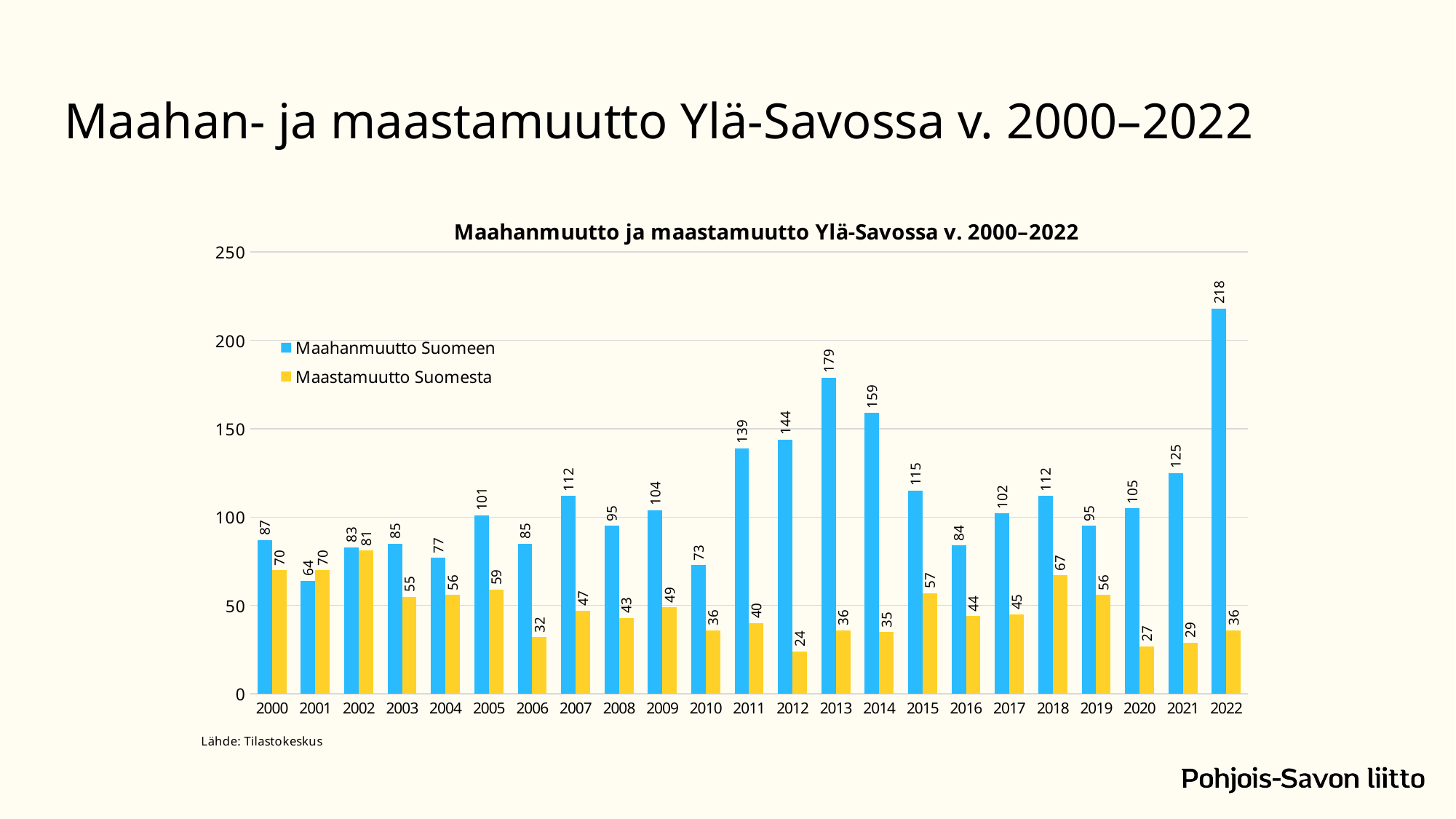
What is the value for Maahanmuutto Suomeen in 2013? 179 Which is larger in 2001: Maahanmuutto Suomeen or Maastamuutto Suomesta? Maastamuutto Suomesta What kind of chart is shown on the slide? Bar chart How many series does the legend list? 2 How many years are shown on the x axis? 23 What is the source cited below the chart? Tilastokeskus What is the value for Maastamuutto Suomesta in 2012? 24 Which year has the lowest value for Maahanmuutto Suomeen? 2001 Which year has the highest value for Maahanmuutto Suomeen? 2022 What is the value for Maahanmuutto Suomeen in 2022? 218 Which year has the lowest value for Maastamuutto Suomesta? 2012 What is the difference between Maahanmuutto Suomeen and Maastamuutto Suomesta in 2022? 182